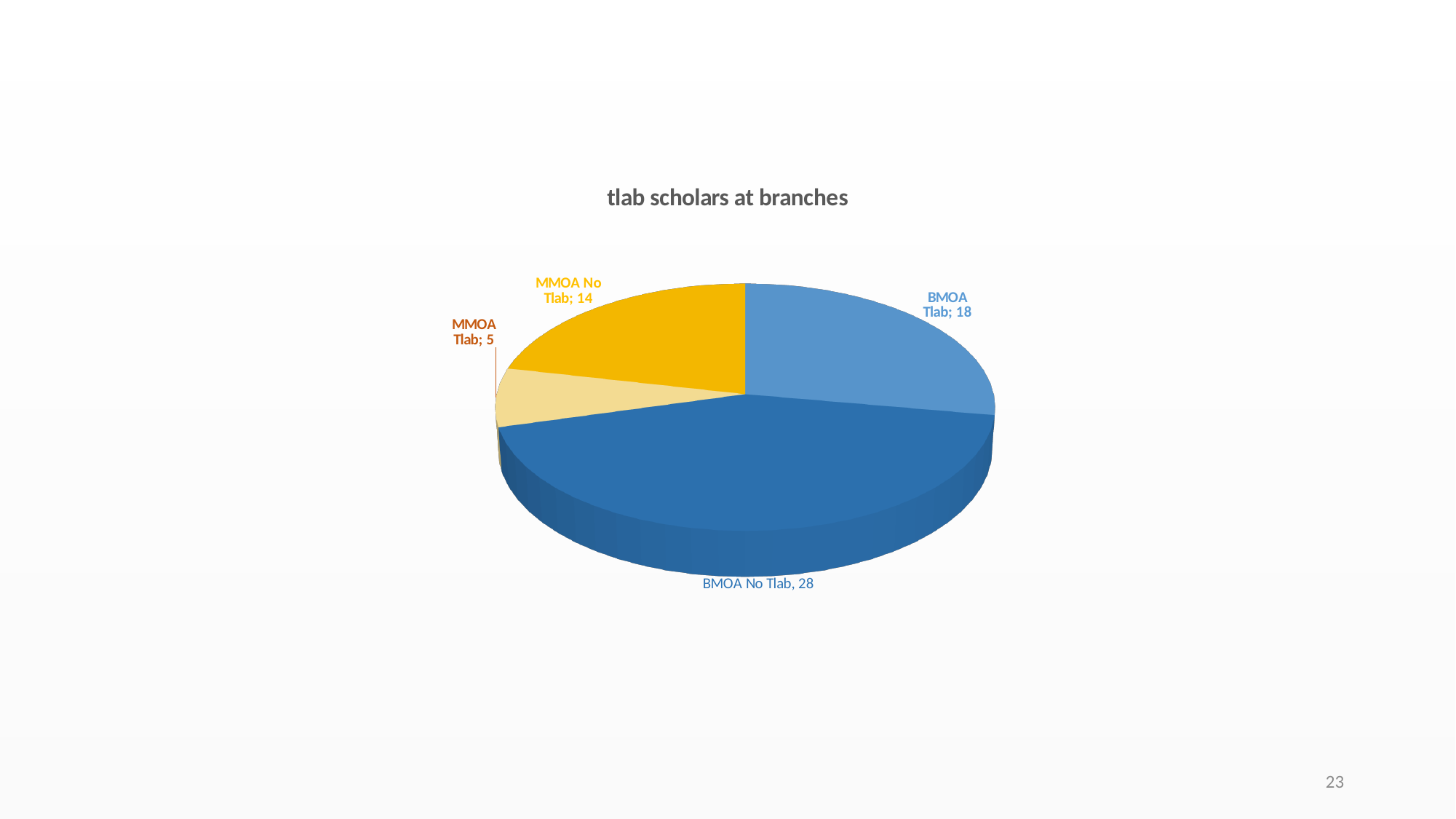
Which is larger, the value for MMOA No Tlab or the value for BMOA Tlab? BMOA Tlab What is the value for MMOA Tlab? 5 What kind of chart is shown on the slide? pie chart Which category has the largest slice? BMOA No Tlab What is the value for MMOA No Tlab? 14 What is the value for BMOA No Tlab? 28 What is the value for BMOA Tlab? 18 How many slices does the pie chart have? 4 Which category has the smallest slice? MMOA Tlab What is the title of the pie chart? tlab scholars at branches What is the total of all four slices in the pie chart? 65 What is the difference between the values for BMOA No Tlab and BMOA Tlab? 10